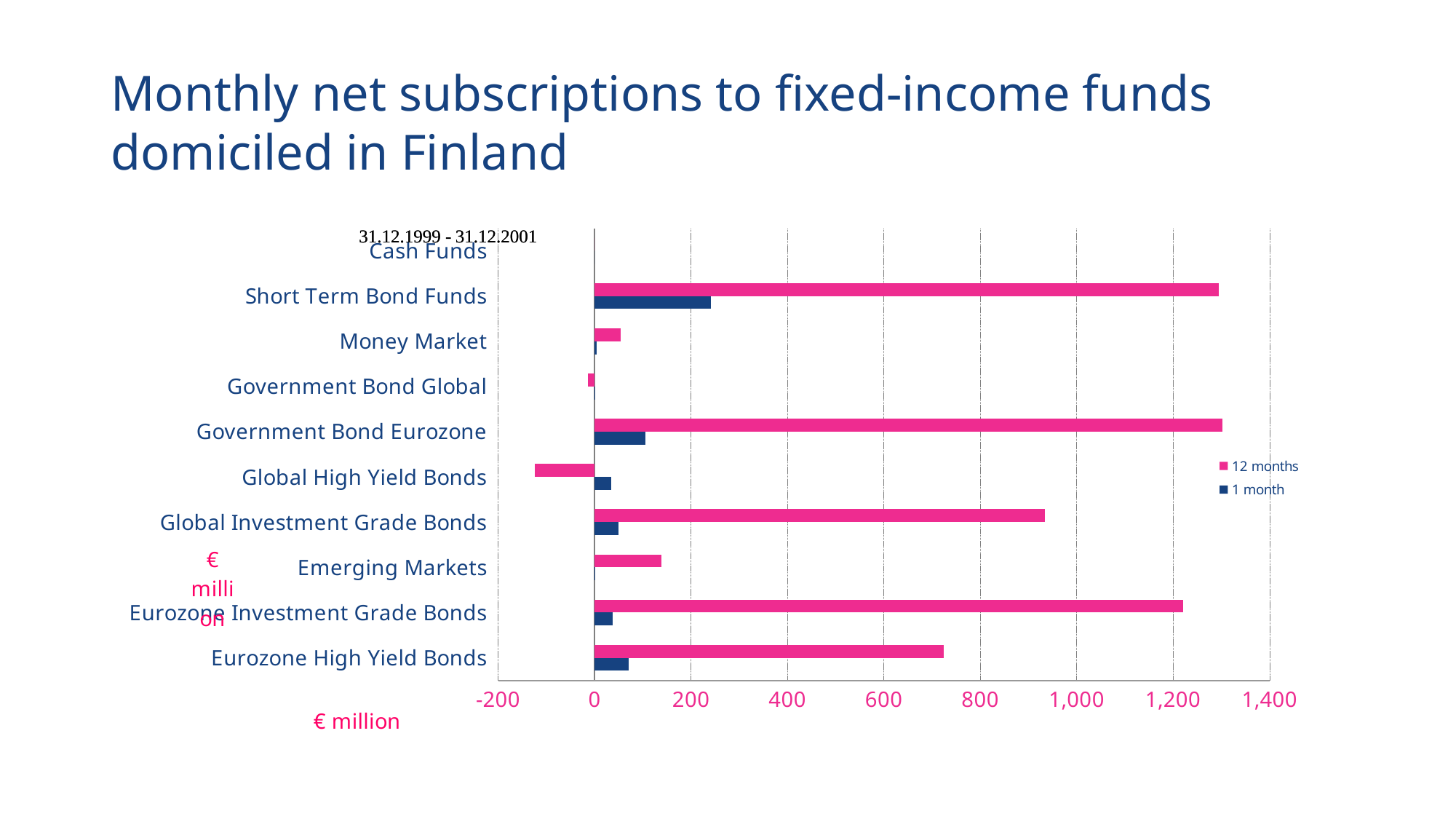
How many fund categories are listed on the vertical axis? 10 How many series does the legend list? 2 Which category has the highest 1 month value? Short Term Bond Funds Is the 12 months value for Global Investment Grade Bonds greater or less than 800? greater Which has the larger 1 month value, Short Term Bond Funds or Government Bond Eurozone? Short Term Bond Funds What unit is shown on the horizontal axis of the chart? € million Which category has the lowest 12 months value? Global High Yield Bonds What kind of chart is shown on the slide? Bar chart Is the 12 months value for Short Term Bond Funds greater or less than 1,200? greater Is the 12 months value for Emerging Markets greater or less than 200? less Which has the larger 12 months value, Eurozone Investment Grade Bonds or Eurozone High Yield Bonds? Eurozone Investment Grade Bonds